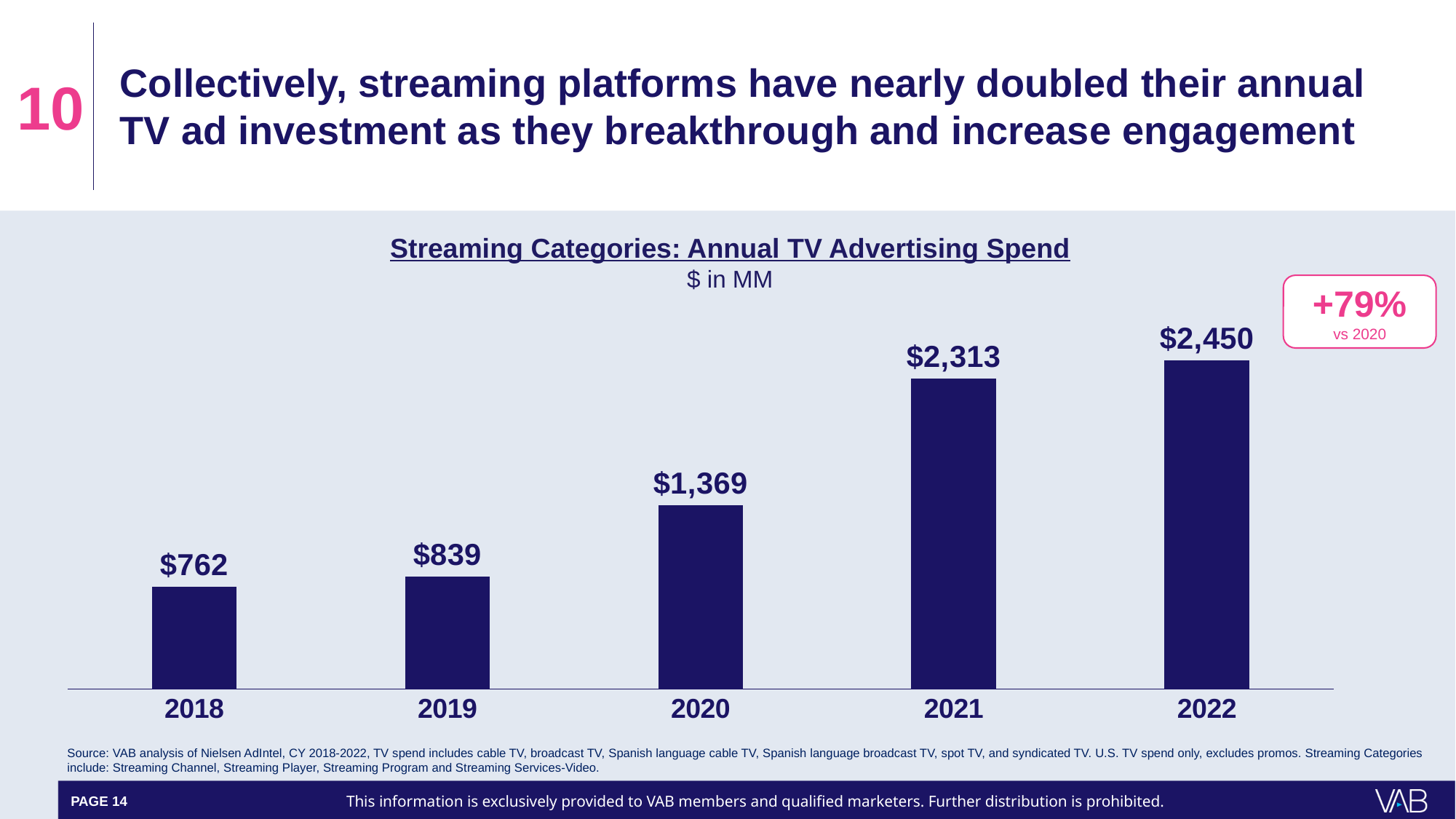
Which year had the highest annual TV advertising spend? 2022 What kind of chart is shown on the slide? Bar chart What was the annual TV advertising spend for streaming categories in 2018? $762 Do the values rise or fall from 2018 to 2022? Rise What was the annual TV advertising spend for streaming categories in 2020? $1,369 How many years are shown on the chart? 5 What was the annual TV advertising spend for streaming categories in 2022? $2,450 Which year had a larger annual TV advertising spend, 2020 or 2021? 2021 What is the difference in annual TV advertising spend between 2022 and 2021? $137 What unit is the chart's data expressed in, according to the subtitle? $ in MM Which year had the lowest annual TV advertising spend? 2018 What is the difference in annual TV advertising spend between 2019 and 2018? $77